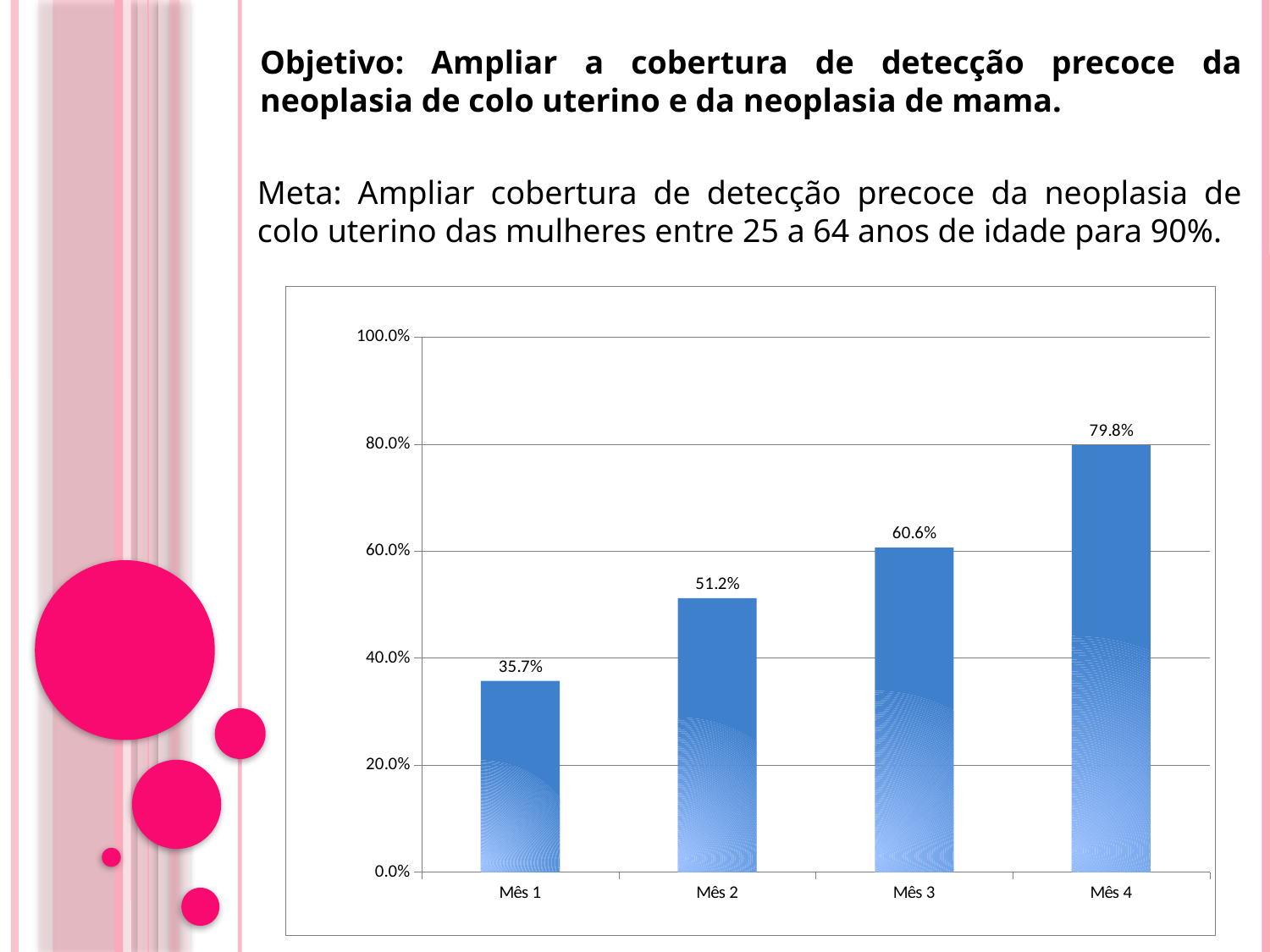
How many months are shown on the x axis? 4 What is the value for Mês 4? 79.8% Which month has the lowest value? Mês 1 What kind of chart is shown on the slide? bar chart Which month has the highest value? Mês 4 What is the difference between the values for Mês 3 and Mês 2? 9.4% What is the value for Mês 2? 51.2% What is the value for Mês 1? 35.7% Is the value for Mês 4 greater or less than 80.0%? less What is the value for Mês 3? 60.6% What is the difference between the values for Mês 4 and Mês 1? 44.1% Which is larger, the value for Mês 2 or the value for Mês 3? Mês 3